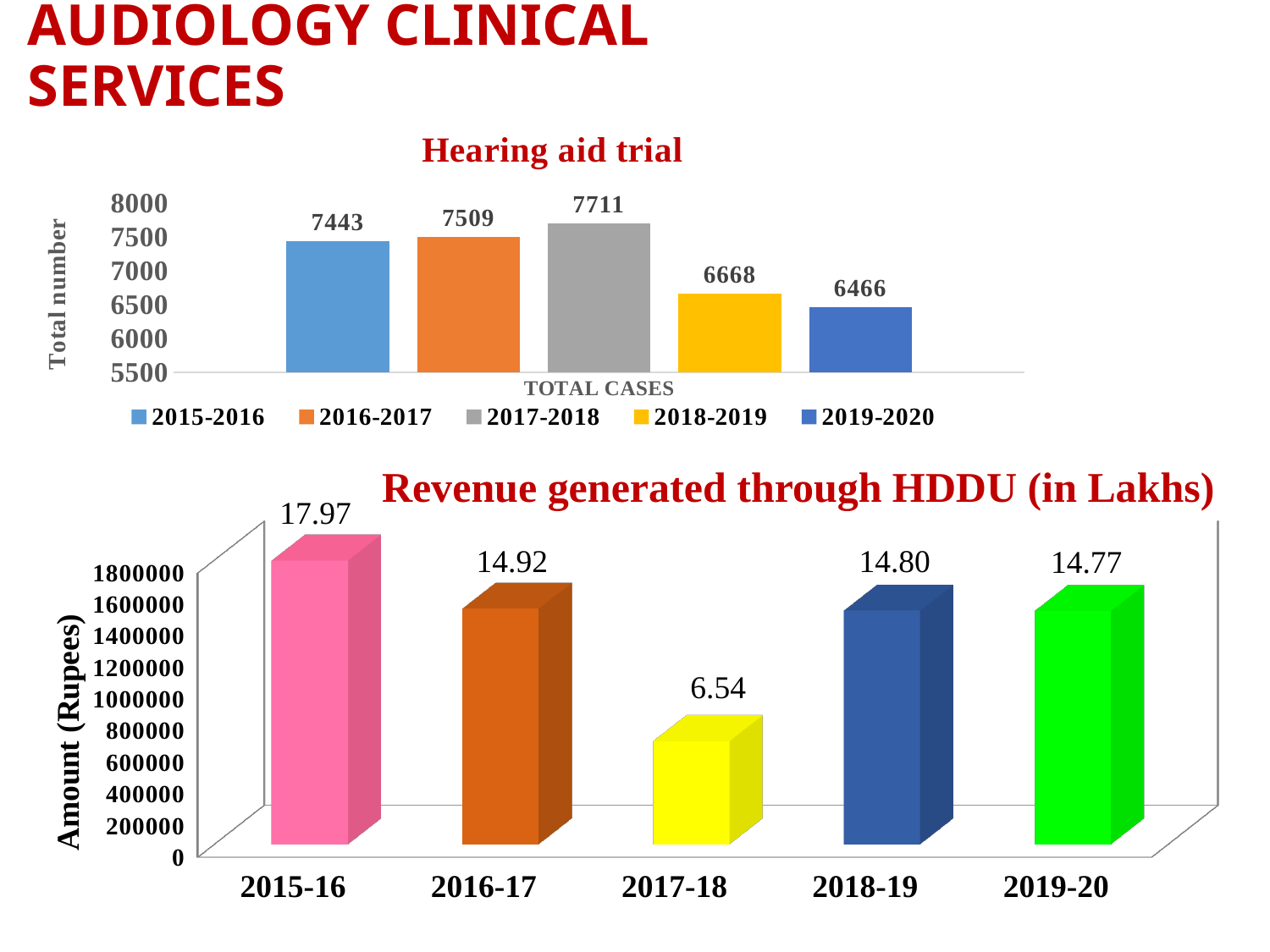
In the 'Hearing aid trial' chart, what is the value for 2017-2018? 7711 In the 'Hearing aid trial' chart, is the value for 2015-2016 greater or less than 7000? greater In the 'Revenue generated through HDDU (in Lakhs)' chart, which year has the highest revenue? 2015-16 In the 'Revenue generated through HDDU (in Lakhs)' chart, which year has the lowest revenue? 2017-18 In the 'Hearing aid trial' chart, what is the difference between the values for 2017-2018 and 2018-2019? 1043 In the 'Revenue generated through HDDU (in Lakhs)' chart, how many years are plotted? 5 In the 'Revenue generated through HDDU (in Lakhs)' chart, what is the value for 2017-18? 6.54 What kind of chart is the 'Revenue generated through HDDU (in Lakhs)' chart? Bar chart In the 'Hearing aid trial' chart, which year has the highest total number? 2017-2018 In the 'Hearing aid trial' chart, how many series does the legend list? 5 In the 'Hearing aid trial' chart, which year has the lowest total number? 2019-2020 In the 'Revenue generated through HDDU (in Lakhs)' chart, which is larger, the value for 2016-17 or the value for 2017-18? 2016-17